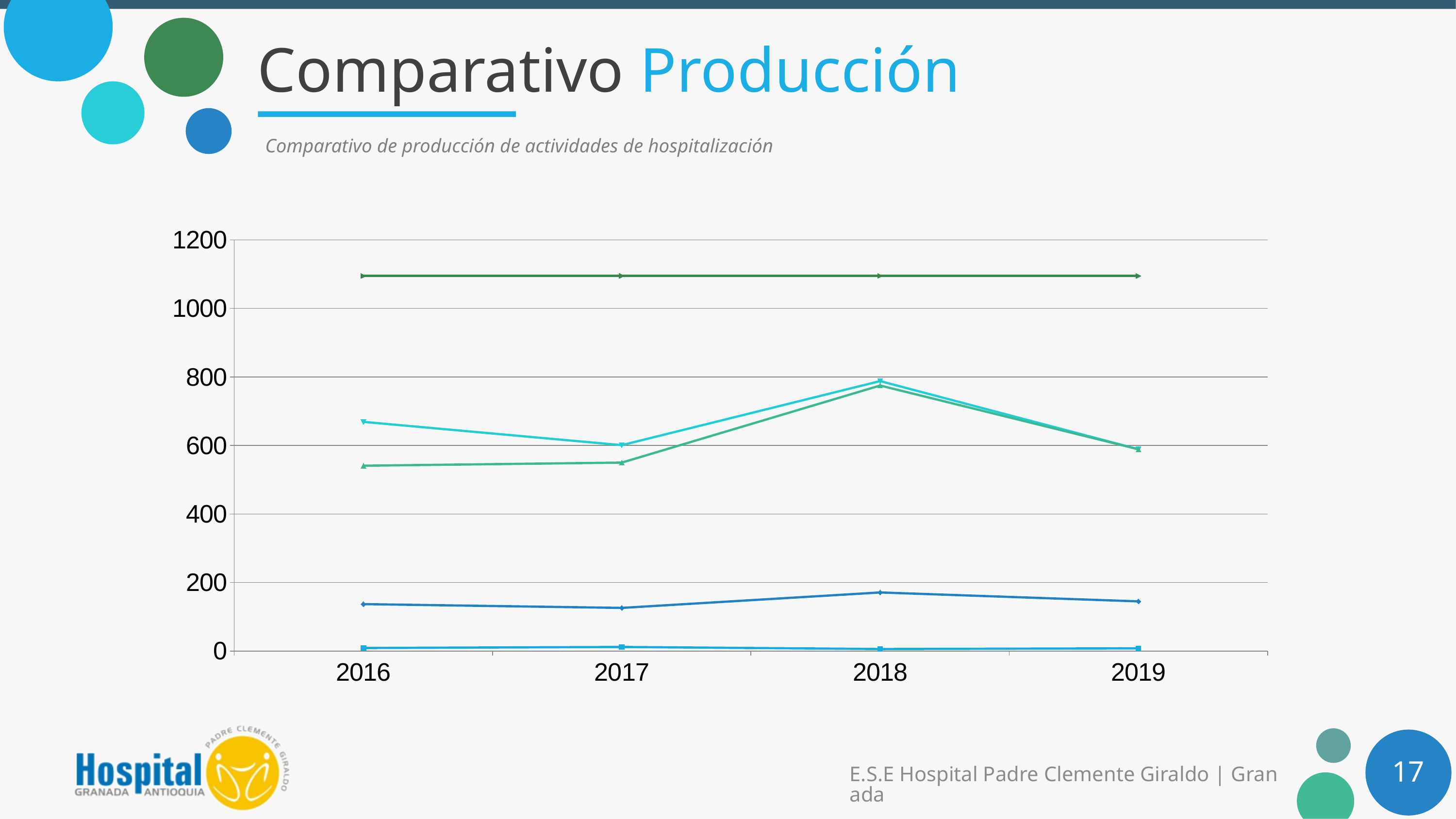
Is the value of the light green line in 2019 greater or less than 800? less What is the highest value shown on the y axis of the chart? 1200 Is the value of the cyan line in 2016 greater or less than 600? greater For the light green line, is the value in 2018 higher or lower than in 2016? higher How many years are shown on the x axis of the chart? 4 Is the value of the dark green line in 2018 greater or less than 1000? greater What is the first year shown on the x axis of the chart? 2016 In which year does the blue line reach its highest value? 2018 Does the dark green line rise, fall, or stay flat from 2016 to 2019? stay flat What kind of chart is shown on the slide? line chart In which year does the cyan line reach its highest value? 2018